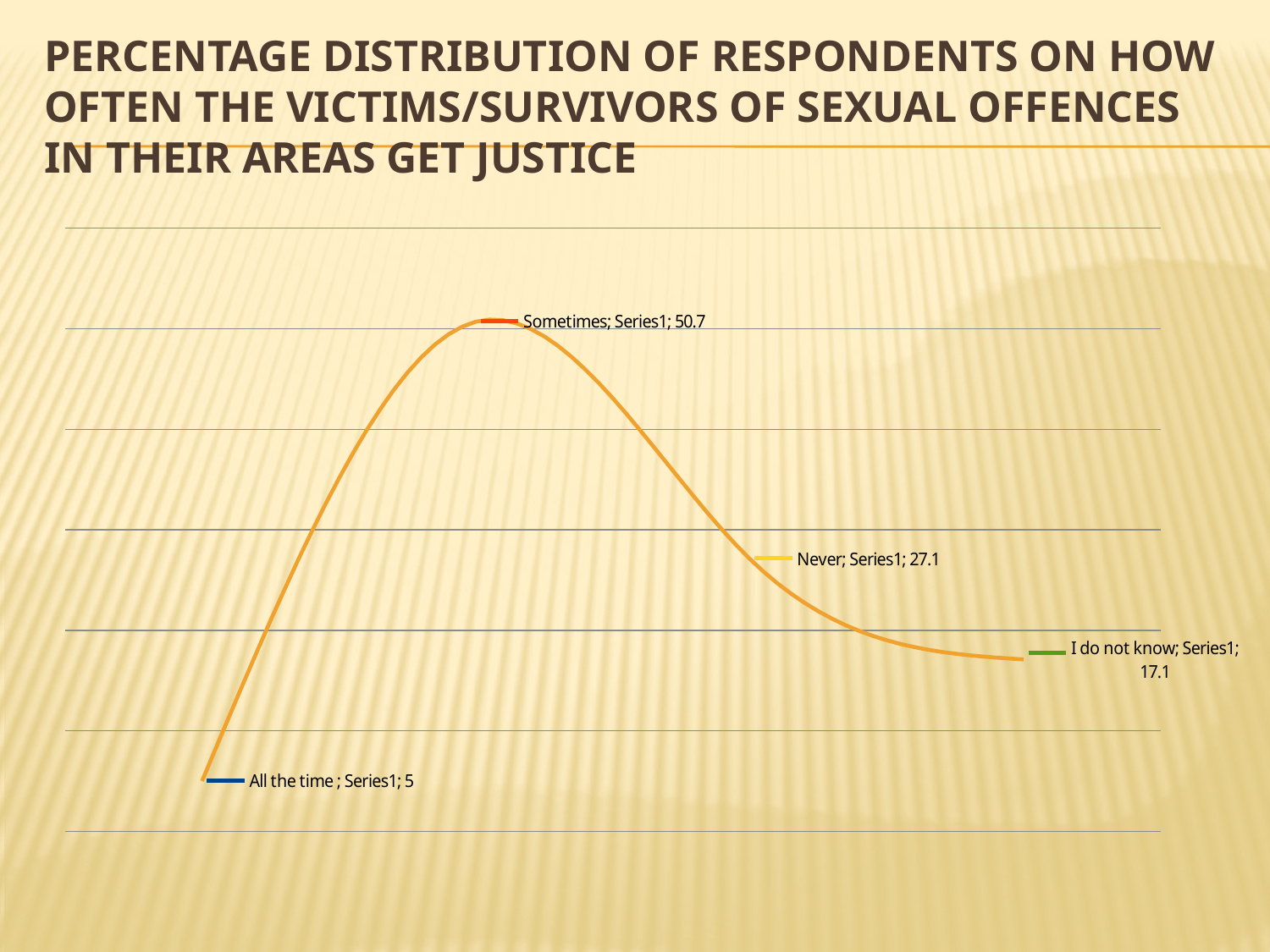
What is the difference between the values for "Never" and "I do not know"? 10 What is the value for "All the time"? 5 What is the name of the series shown in the data labels? Series1 What is the value for "Never"? 27.1 Which is larger, the value for "Never" or the value for "I do not know"? Never What is the difference between the values for "Sometimes" and "Never"? 23.6 Which category has the highest value? Sometimes How many categories are plotted on the chart? 4 What is the value for "I do not know"? 17.1 What is the value for "Sometimes"? 50.7 Which category has the lowest value? All the time What kind of chart is shown on the slide? Line chart